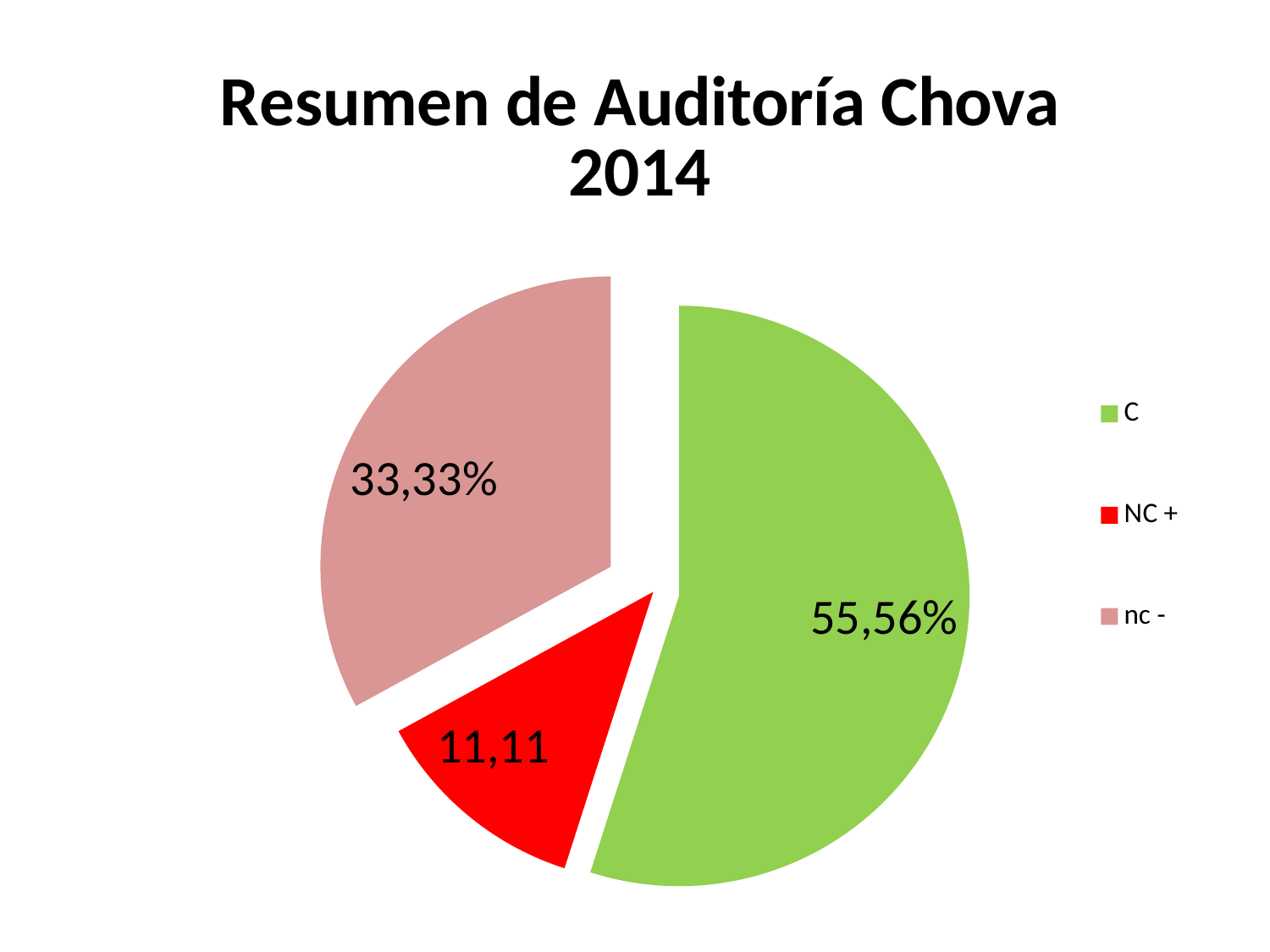
What colour is the slice for NC +? red Which category has the largest slice of the pie? C What type of chart is shown on the slide? pie chart What is the value shown for the C slice? 55,56% What is the value shown for the nc - slice? 33,33% Which is larger, the slice for NC + or the slice for nc -? nc - What is the value shown for the NC + slice? 11,11 Which category has the smallest slice of the pie? NC + How many entries does the legend list? 3 Which is larger, the slice for C or the slice for nc -? C What is the title of the slide? Resumen de Auditoría Chova 2014 How many slices does the pie chart have? 3